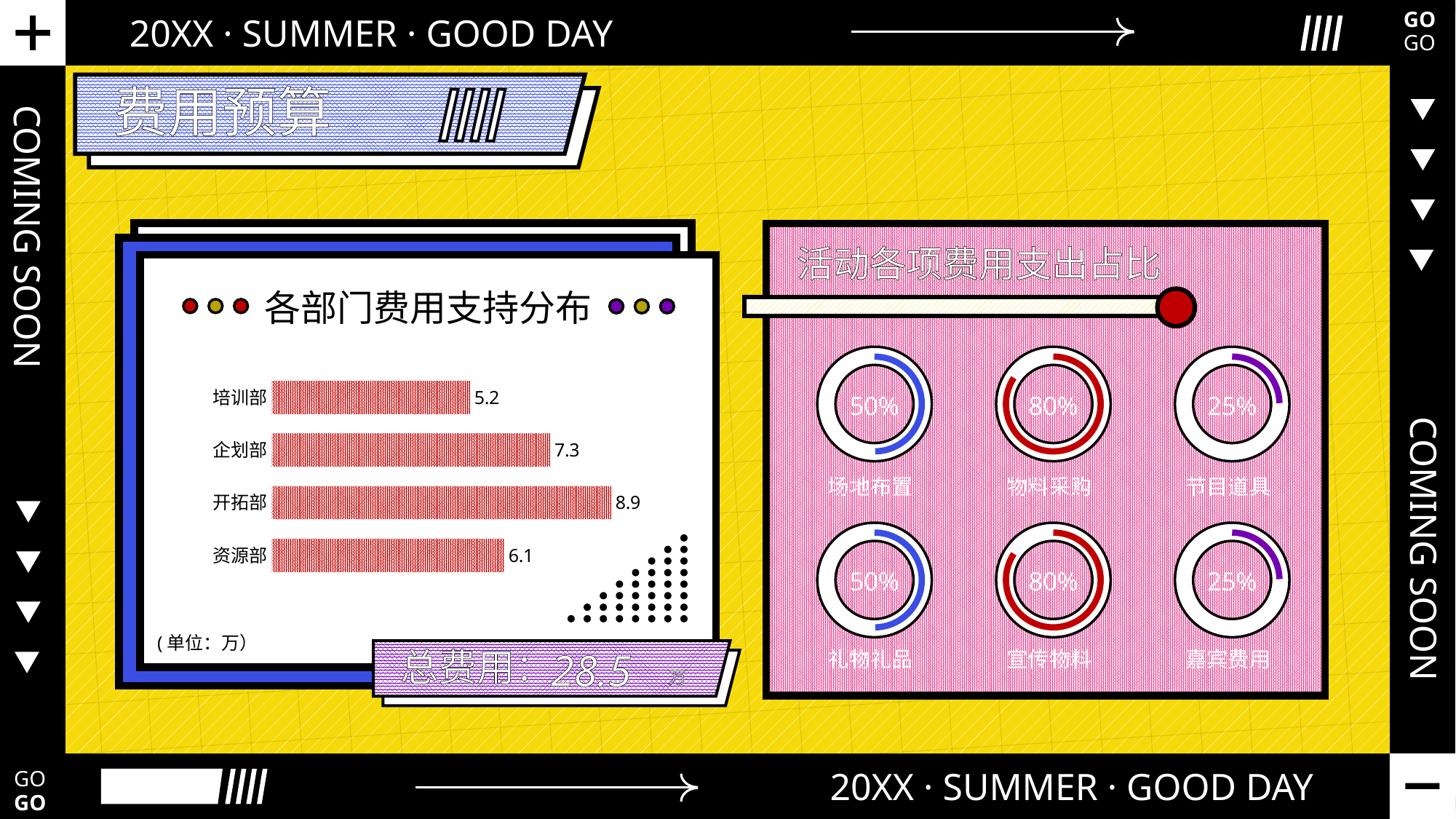
In the bar chart titled 各部门费用支持分布, what is the value for 培训部? 5.2 What unit is stated for the values in the bar chart titled 各部门费用支持分布? 万 In the bar chart titled 各部门费用支持分布, which is larger, the value for 企划部 or the value for 资源部? 企划部 In the ring charts under 活动各项费用支出占比, what percentage is shown for 物料采购? 80% In the bar chart titled 各部门费用支持分布, which department has the highest value? 开拓部 How many departments are shown in the bar chart titled 各部门费用支持分布? 4 How many ring charts are shown under the title 活动各项费用支出占比? 6 In the bar chart titled 各部门费用支持分布, what is the value for 开拓部? 8.9 In the bar chart titled 各部门费用支持分布, which department has the lowest value? 培训部 What kind of chart is the one titled 各部门费用支持分布? bar chart In the ring charts under 活动各项费用支出占比, what percentage is shown for 嘉宾费用? 25% In the bar chart titled 各部门费用支持分布, what is the difference between the values for 企划部 and 资源部? 1.2